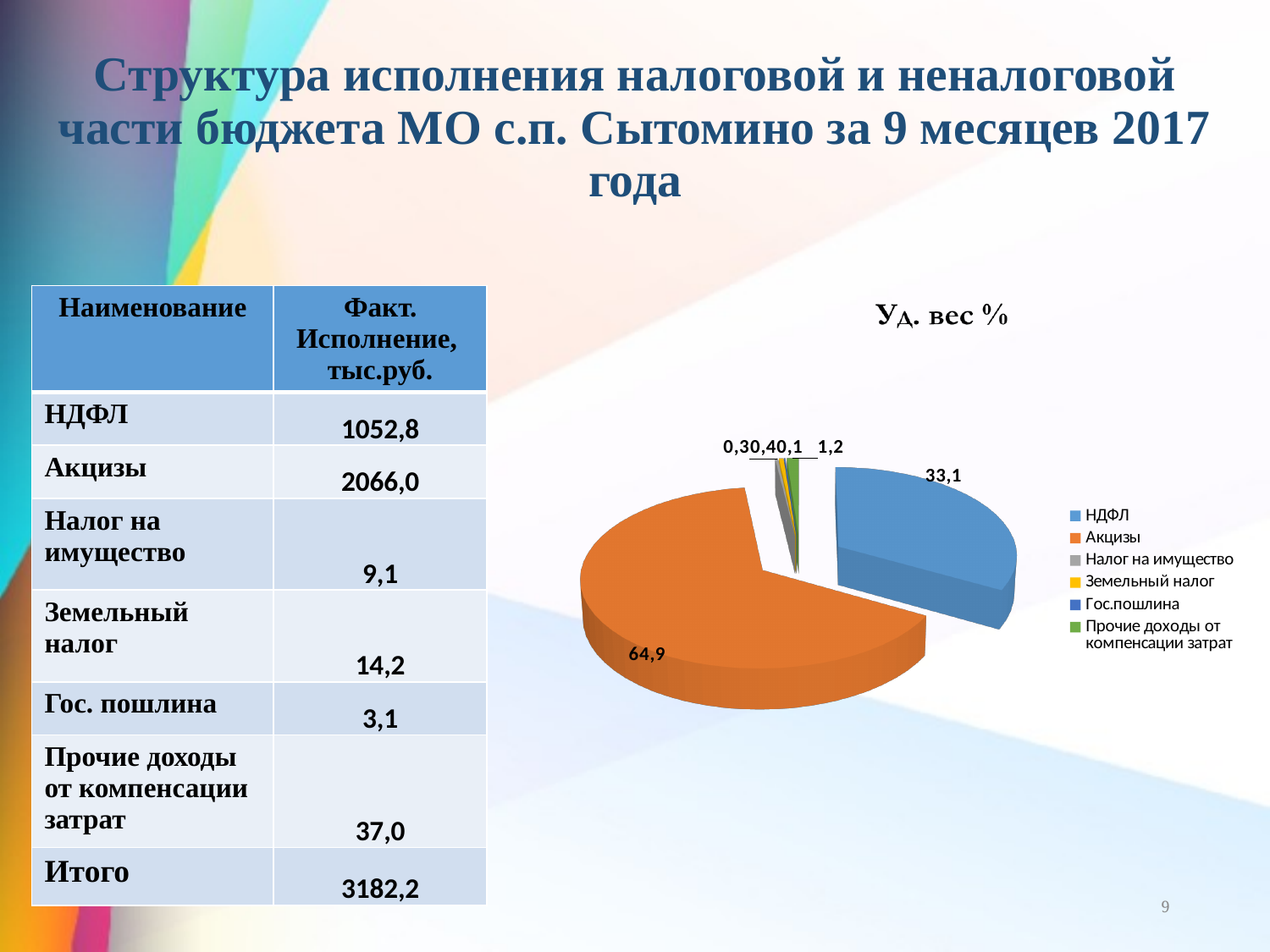
How many categories does the legend of the pie chart list? 6 Which category has the largest slice in the pie chart? Акцизы What colour is the Акцизы slice in the pie chart? orange What share does Акцизы have in the pie chart? 64,9 What is the difference between the shares of Акцизы and НДФЛ in the pie chart? 31,8 Which is larger in the pie chart, НДФЛ or Налог на имущество? НДФЛ What is the title of the chart? Уд. вес % What share does НДФЛ have in the pie chart? 33,1 What kind of chart is shown on the slide? pie chart Which is larger in the pie chart, НДФЛ or Акцизы? Акцизы